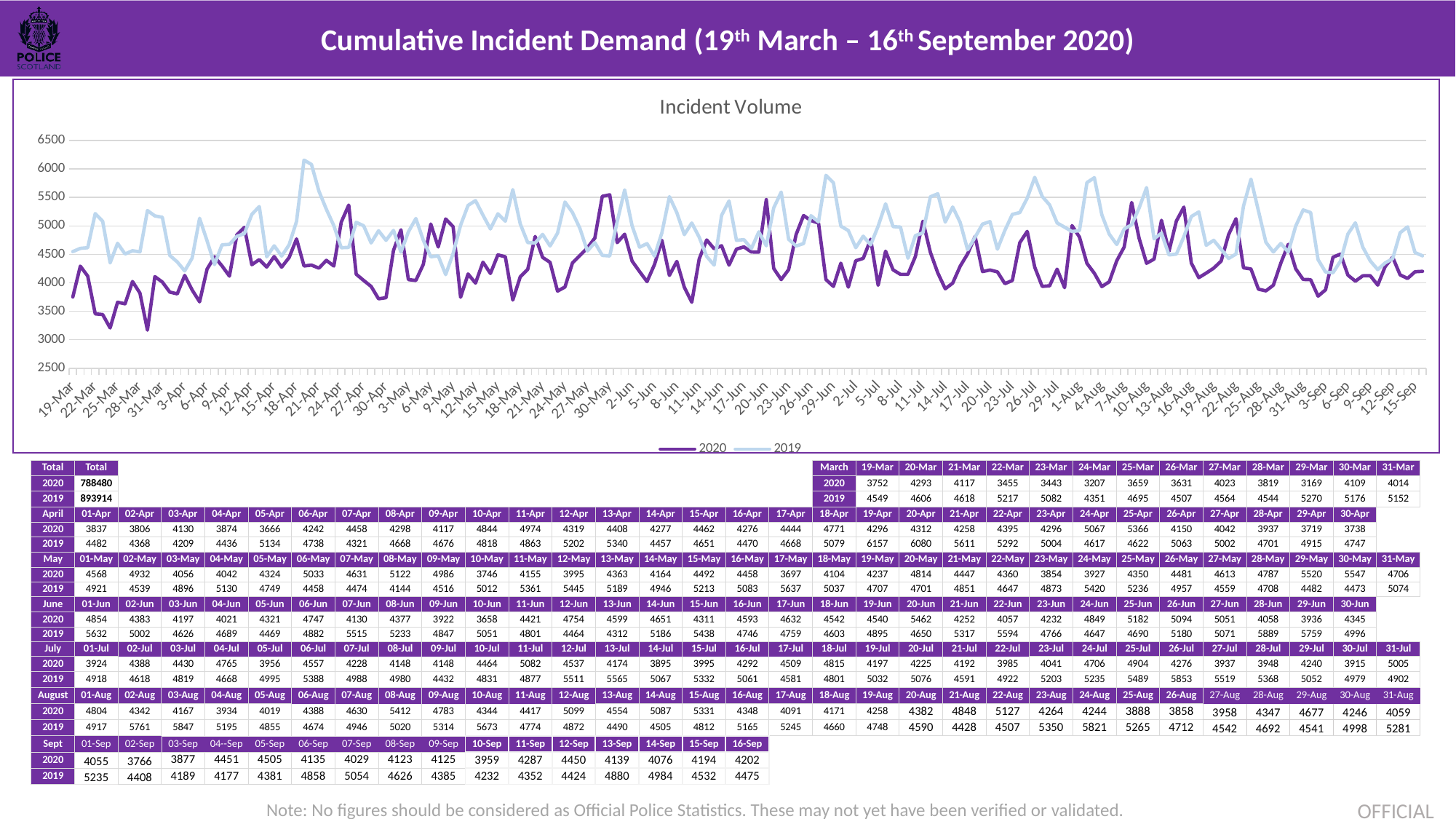
What is the total incident volume for 2019 shown in the table? 893914 What kind of chart is shown on the slide? Line chart Which year has the larger total incident volume, 2019 or 2020? 2019 What is the title shown above the chart area? Incident Volume What is the difference between the 2019 total and the 2020 total incident volume? 105434 On which March date is the 2020 incident volume lowest? 29-Mar What are the two series named in the chart legend? 2020 and 2019 On which April date is the 2019 incident volume highest? 19-Apr What is the 2020 incident volume on 19-Mar? 3752 How many series does the chart legend list? 2 What is the total incident volume for 2020 shown in the table? 788480 Is the 2020 incident volume on 19-Mar greater or less than 4000? less